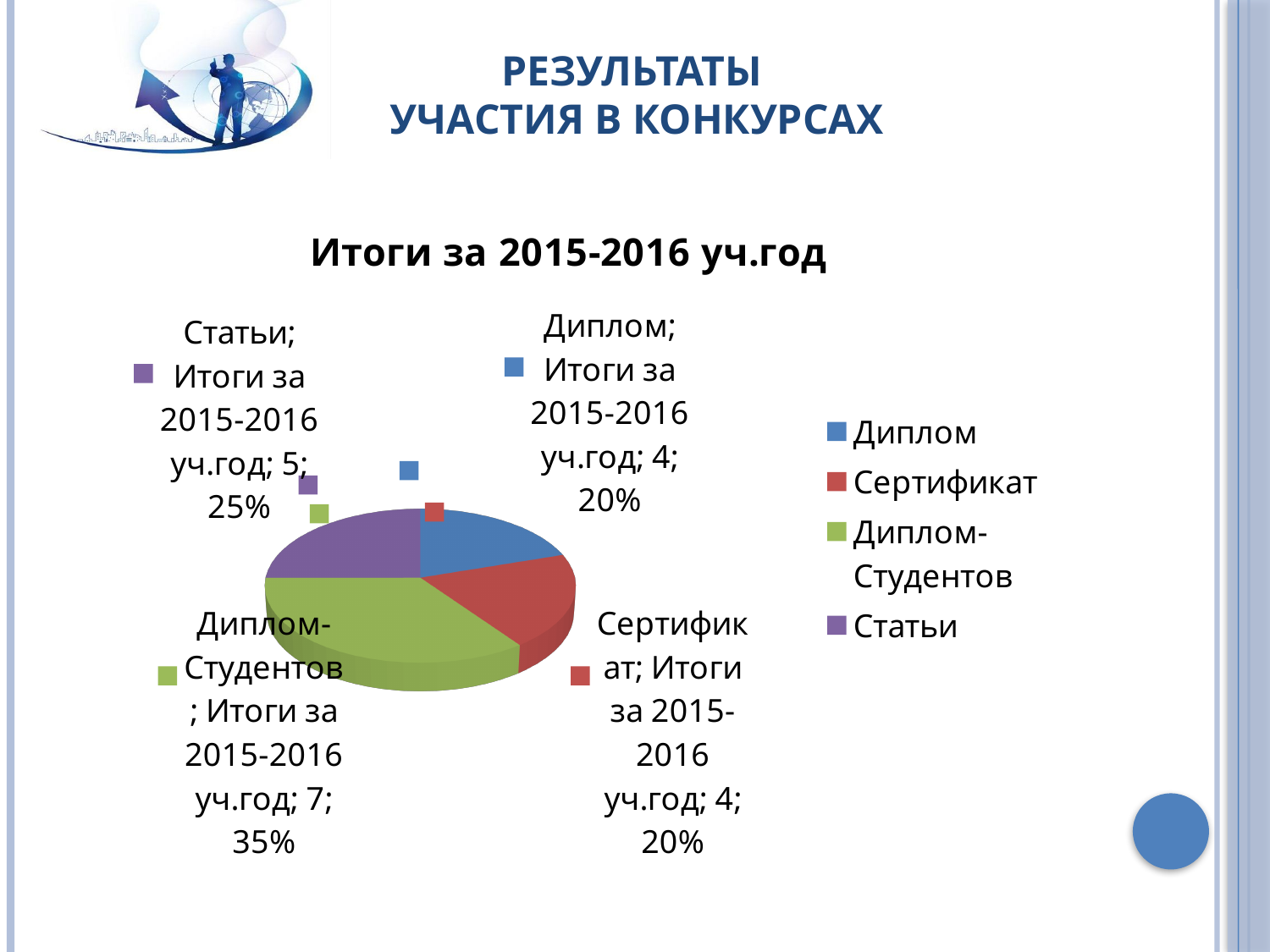
What is the value for Сертификат? 4 What is the value for Статьи? 5 Which is larger, the value for Статьи or the value for Диплом? Статьи What is the difference between the values for Диплом-Студентов and Статьи? 2 How many slices does the pie chart have? 4 What kind of chart is shown on the slide? pie chart What share of the pie does Диплом-Студентов take? 35% Which category has the largest slice? Диплом-Студентов How many entries does the legend list? 4 What is the title of the chart? Итоги за 2015-2016 уч.год What is the value for Диплом-Студентов? 7 What share of the pie does Диплом take? 20%